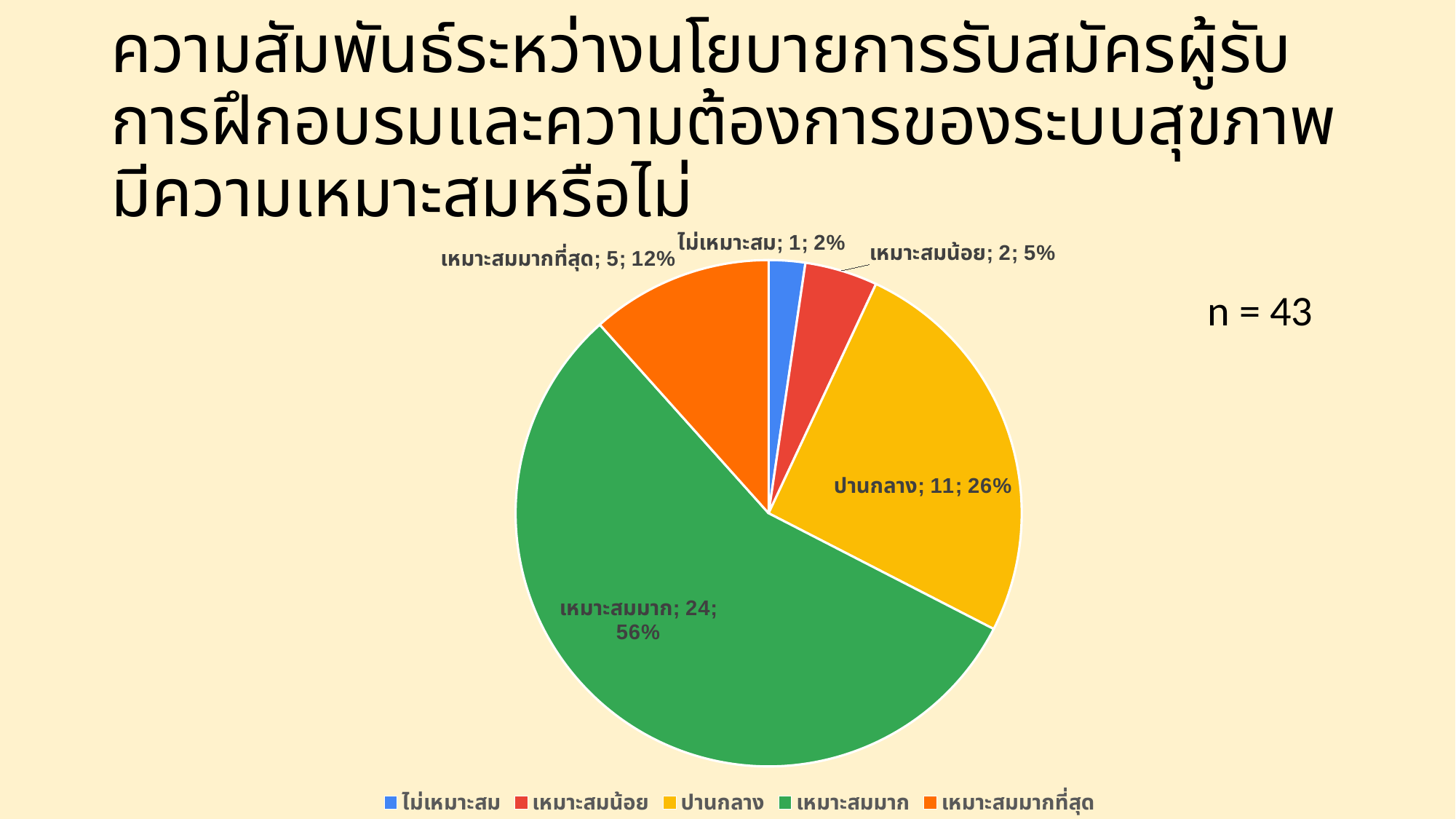
What percentage share does ไม่เหมาะสม have? 2% What type of chart is shown on the slide? pie chart What is the difference in count between เหมาะสมมาก and ปานกลาง? 13 How many entries does the legend list? 5 Which has a larger count, เหมาะสมน้อย or เหมาะสมมากที่สุด? เหมาะสมมากที่สุด How many slices does the pie chart have? 5 What is the count for เหมาะสมมากที่สุด? 5 What colour is the slice for ปานกลาง? yellow Which category has the largest slice? เหมาะสมมาก Which category has the smallest slice? ไม่เหมาะสม What is the count for ปานกลาง? 11 What percentage share does เหมาะสมมาก have? 56%